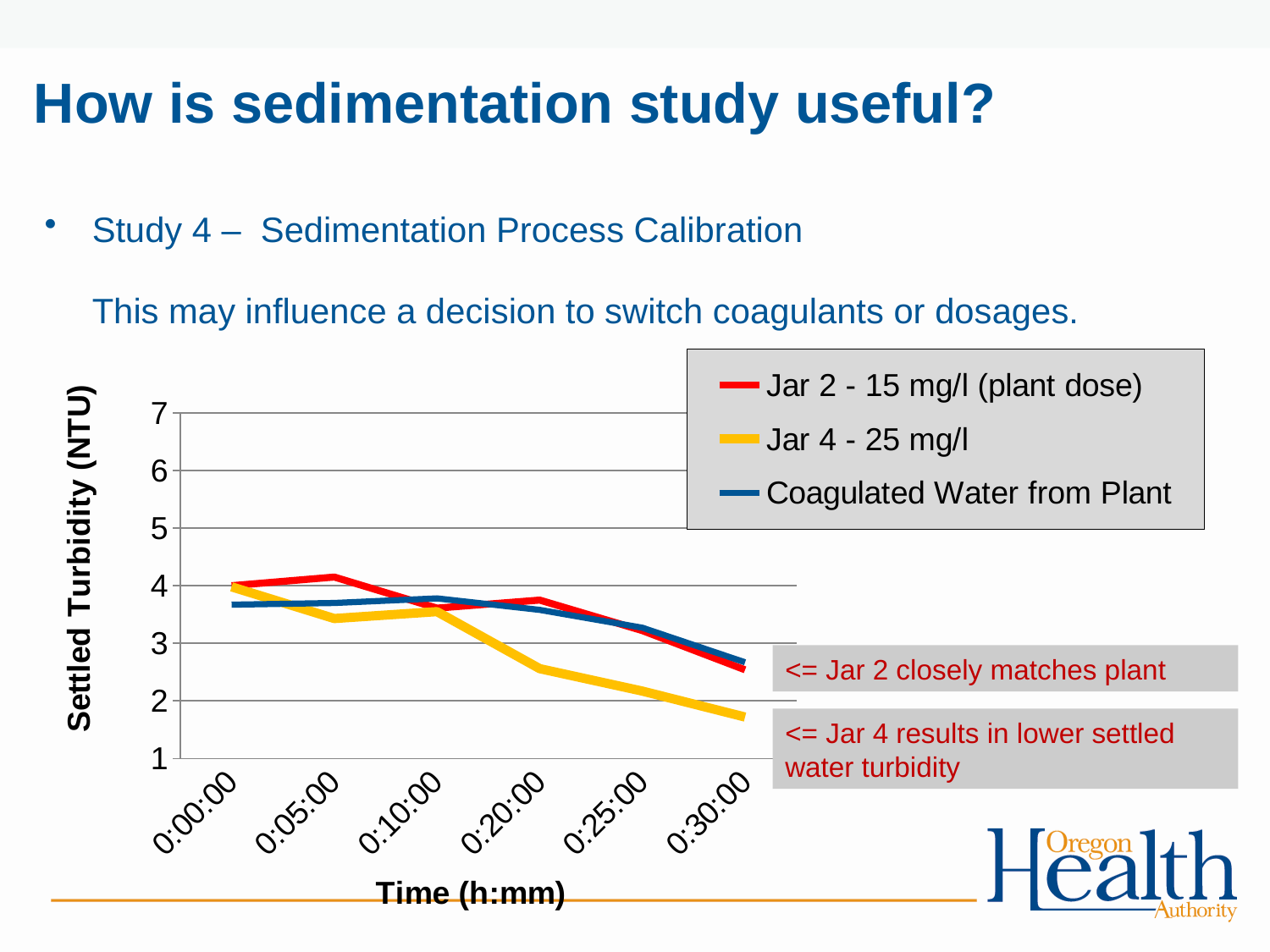
Which series has the lowest settled turbidity at 0:30:00? Jar 4 - 25 mg/l Is the value for Jar 2 - 15 mg/l (plant dose) at 0:05:00 greater or less than 4? greater Does the settled turbidity for Jar 4 - 25 mg/l rise or fall from 0:00:00 to 0:30:00? fall What is the title of the y axis? Settled Turbidity (NTU) At 0:20:00, which is larger: Coagulated Water from Plant or Jar 4 - 25 mg/l? Coagulated Water from Plant Is the value for Jar 4 - 25 mg/l at 0:20:00 greater or less than 3? less Which series has the highest settled turbidity at 0:05:00? Jar 2 - 15 mg/l (plant dose) How many series does the legend list? 3 Which series is drawn in red? Jar 2 - 15 mg/l (plant dose) Is the value for Jar 4 - 25 mg/l at 0:30:00 greater or less than 2? less How many time points are shown on the x axis? 6 What kind of chart is shown on the slide? line chart